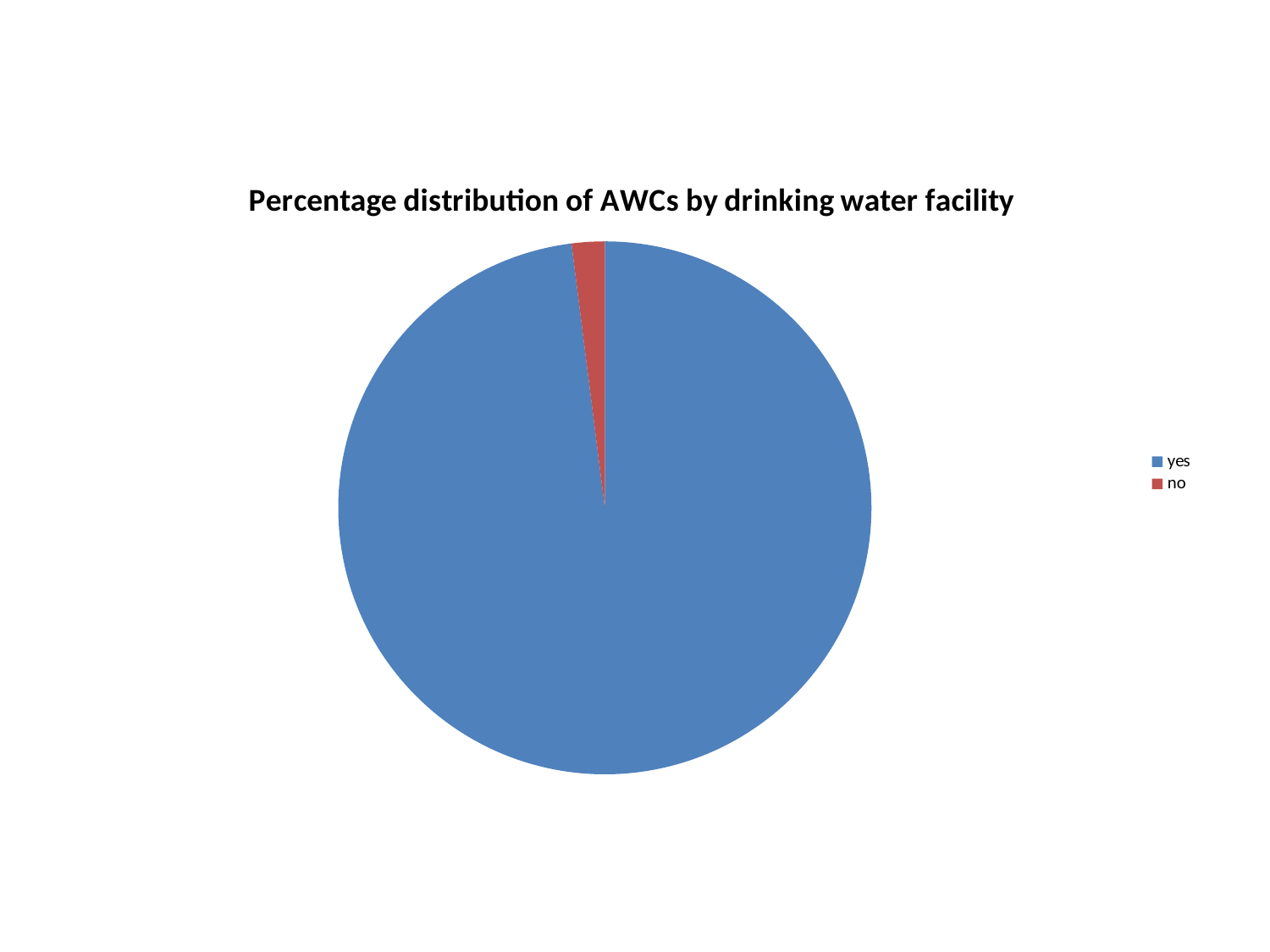
What is the title of the chart? Percentage distribution of AWCs by drinking water facility What kind of chart is shown on the slide? pie chart What colour is the slice for "no"? red Which slice is larger, "yes" or "no"? yes Is the share of the "yes" slice greater or less than 50%? greater Is the share of the "no" slice greater or less than 10%? less Which category has the smallest slice of the pie? no Which category has the largest slice of the pie? yes How many categories does the legend list? 2